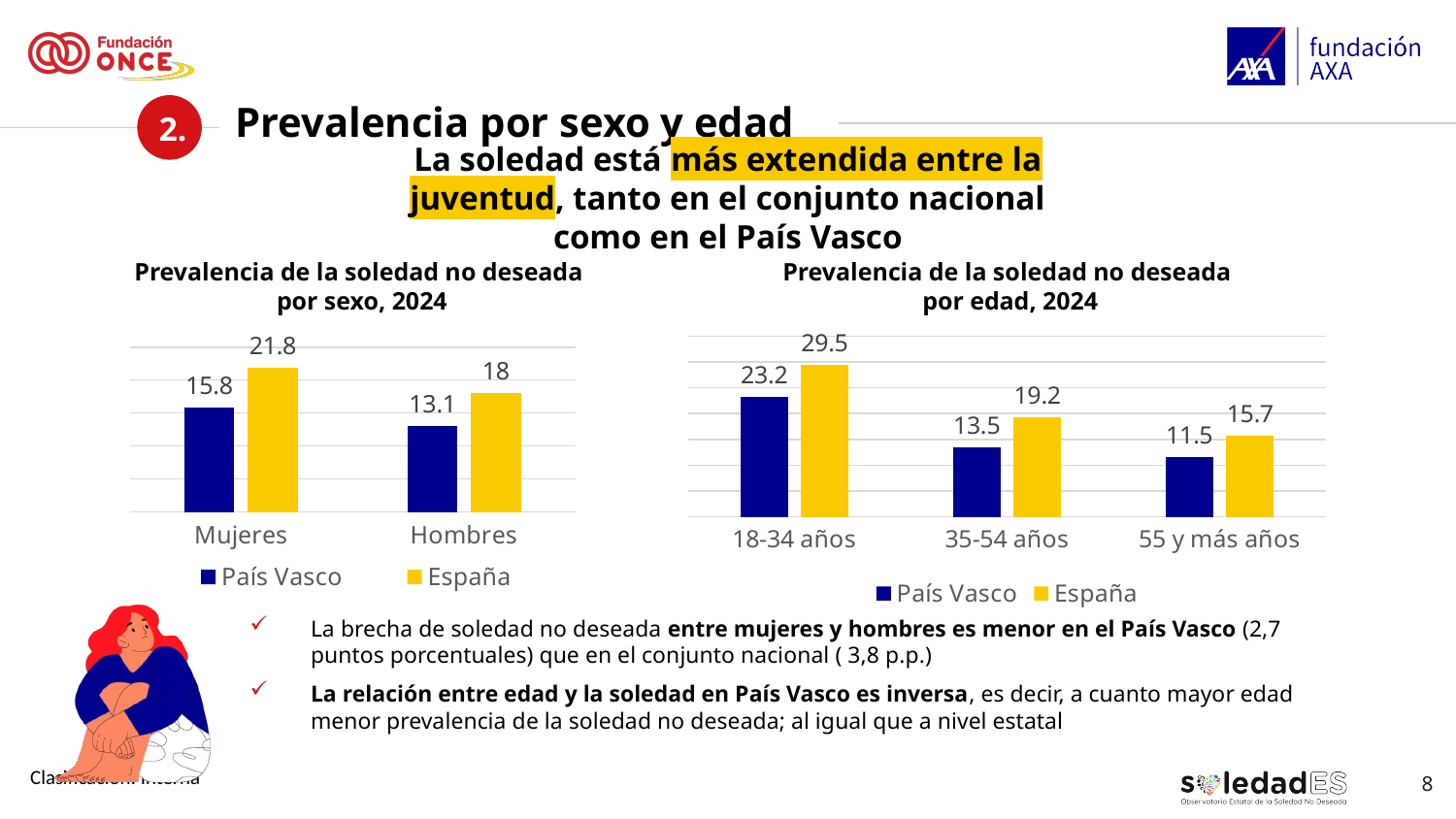
In the chart 'Prevalencia de la soledad no deseada por sexo, 2024', which is larger: the País Vasco value for Mujeres or the País Vasco value for Hombres? Mujeres In the chart 'Prevalencia de la soledad no deseada por edad, 2024', what is the value for 35-54 años in España? 19.2 In the chart 'Prevalencia de la soledad no deseada por sexo, 2024', what is the difference between the España and País Vasco values for Mujeres? 6 In the chart 'Prevalencia de la soledad no deseada por edad, 2024', how many age groups are shown? 3 In the chart 'Prevalencia de la soledad no deseada por sexo, 2024', how many series does the legend list? 2 In the chart 'Prevalencia de la soledad no deseada por sexo, 2024', what is the value for Hombres in España? 18 In the chart 'Prevalencia de la soledad no deseada por sexo, 2024', what is the value for Mujeres in País Vasco? 15.8 In the chart 'Prevalencia de la soledad no deseada por edad, 2024', which age group has the lowest value for País Vasco? 55 y más años In the chart 'Prevalencia de la soledad no deseada por edad, 2024', do the País Vasco values rise or fall as age increases along the x axis? fall In the chart 'Prevalencia de la soledad no deseada por edad, 2024', which age group has the highest value for España? 18-34 años In the chart 'Prevalencia de la soledad no deseada por edad, 2024', what is the difference between the España and País Vasco values for 18-34 años? 6.3 In the chart 'Prevalencia de la soledad no deseada por edad, 2024', what is the value for 55 y más años in País Vasco? 11.5